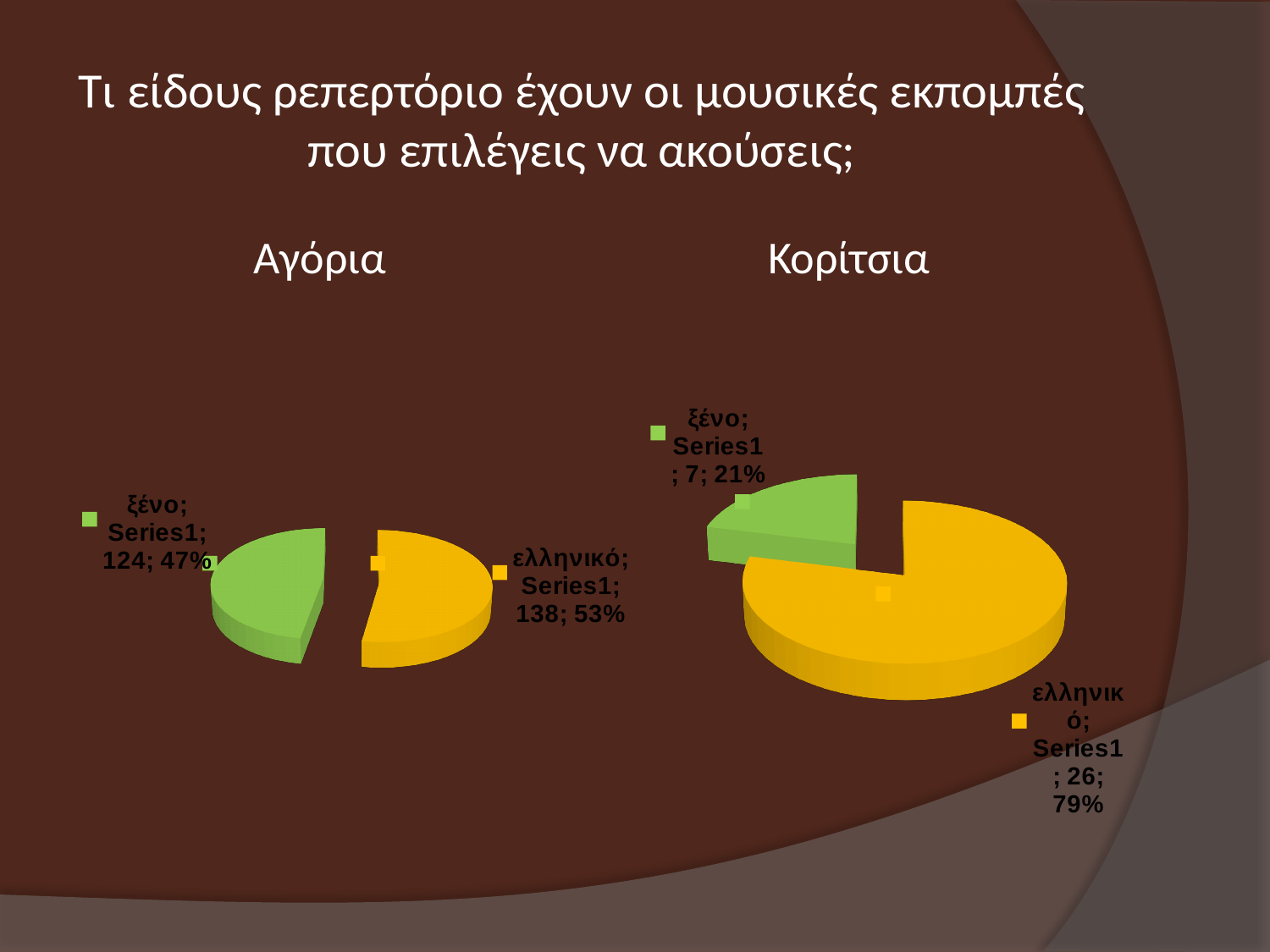
In the Αγόρια chart, what share of the pie does ελληνικό take? 53% In the Αγόρια chart, what is the difference between the values for ελληνικό and ξένο? 14 In the Κορίτσια chart, what is the value for ελληνικό? 26 In the Αγόρια chart, which category is the smallest? ξένο What kind of chart is the Αγόρια chart? pie chart How many slices does the Κορίτσια chart have? 2 In the Κορίτσια chart, what is the difference between the values for ελληνικό and ξένο? 19 In the Κορίτσια chart, what is the value for ξένο? 7 In the Κορίτσια chart, which category is the largest? ελληνικό In the Αγόρια chart, what is the value for ξένο? 124 In the Κορίτσια chart, what share of the pie does ξένο take? 21% In the Αγόρια chart, what is the value for ελληνικό? 138